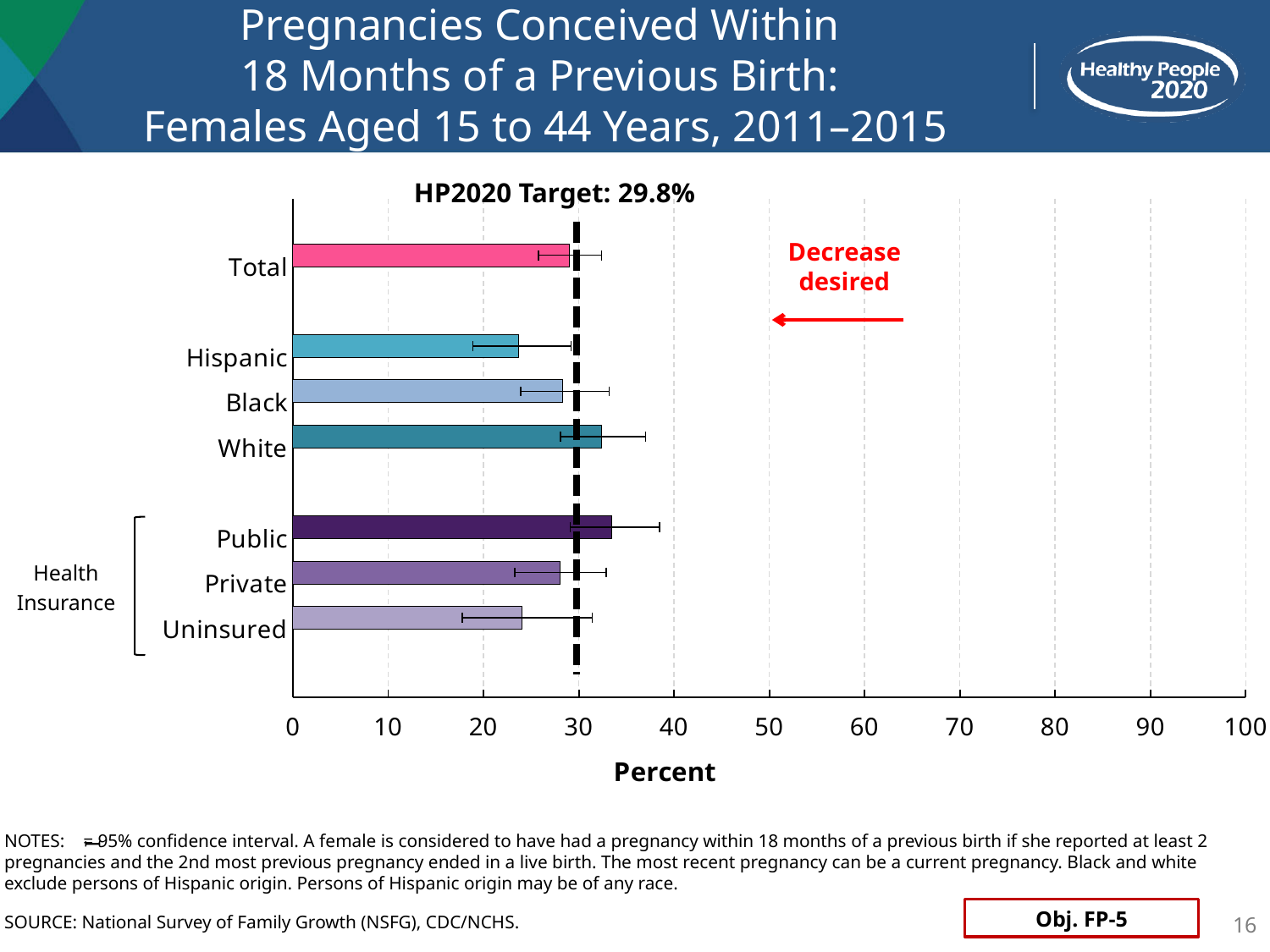
Which has the larger value, White or Hispanic? White Which has the larger value, Public or Uninsured? Public What kind of chart is shown on the slide? bar chart What is the HP2020 Target value shown on the chart? 29.8% Is the value for Public greater or less than 40? less Is the value for Private greater or less than 30? less What is the label of the x axis? Percent Is the value for White greater or less than 30? greater How many bars (categories) are plotted in the chart? 7